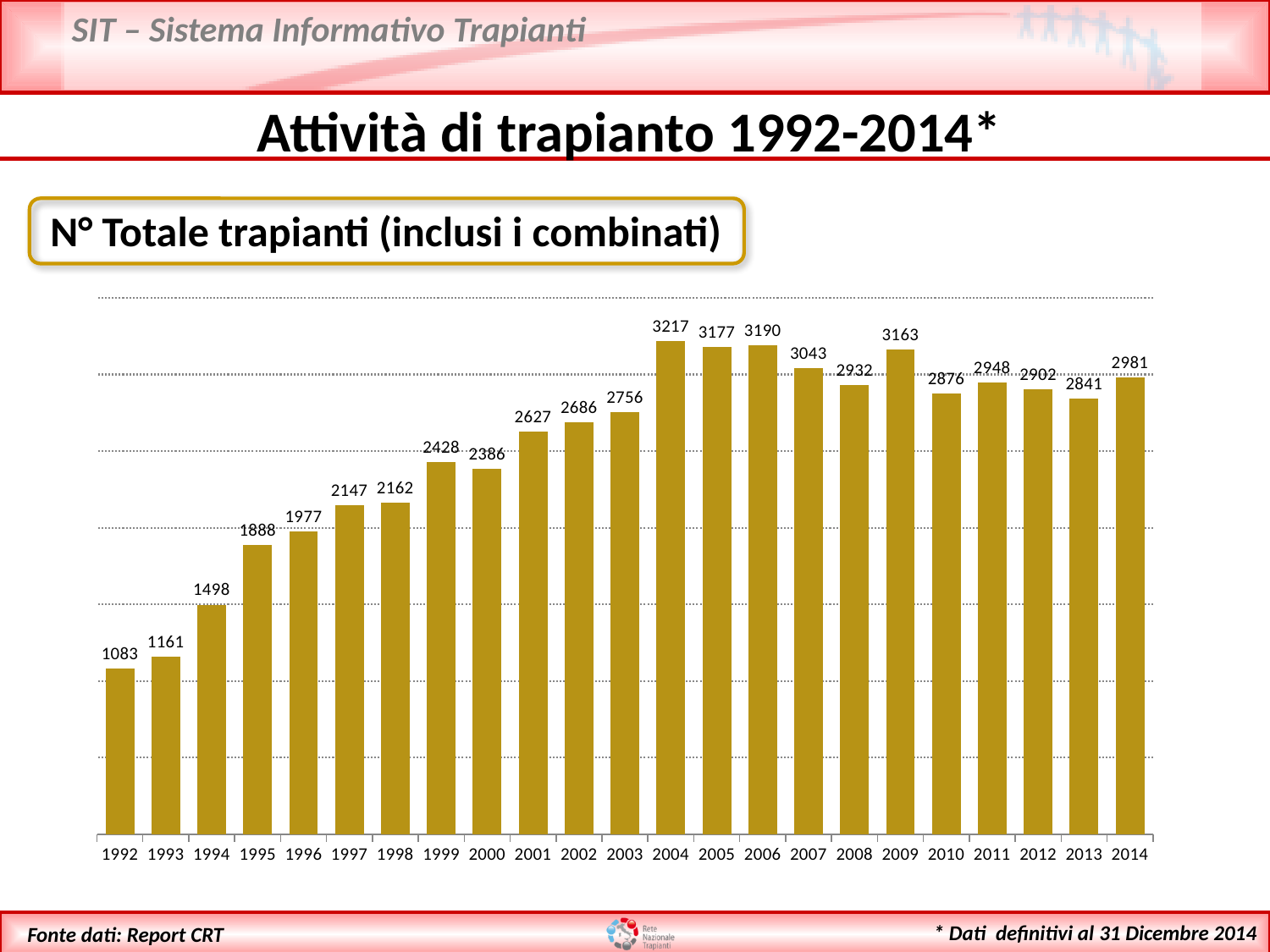
What is the value for 2004? 3217 What is the difference between the values for 2004 and 1992? 2134 Which year has the lowest value? 1992 Do the values generally rise or fall from 1992 to 2004? rise Which year has the highest value? 2004 What is the difference between the values for 2014 and 2013? 140 What is the value for 2014? 2981 What is the title of the chart? N° Totale trapianti (inclusi i combinati) What kind of chart is this? bar chart How many years are shown on the x axis? 23 Which is larger, the value for 2000 or the value for 1999? 1999 What is the value for 1992? 1083